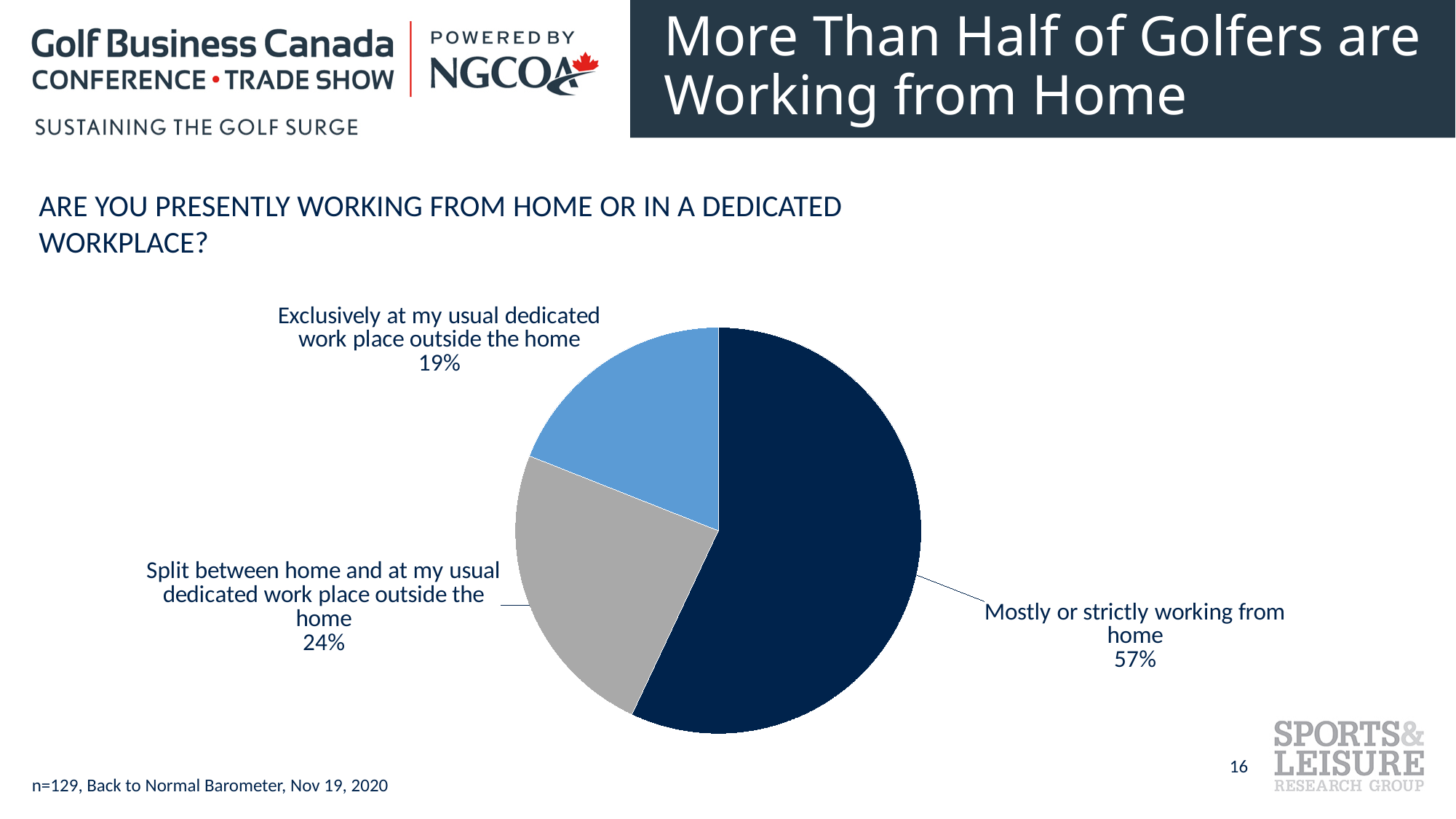
What share of golfers are mostly or strictly working from home? 57% What percentage of golfers are split between home and their usual dedicated work place outside the home? 24% What is the combined share of golfers who work at least partly outside the home (split plus exclusively at work place)? 43% Which category has the largest share of the pie? Mostly or strictly working from home Which category has the smallest share of the pie? Exclusively at my usual dedicated work place outside the home Which is larger: the share split between home and the usual work place, or the share exclusively at the usual work place? Split between home and at my usual dedicated work place outside the home What is the difference in percentage points between 'Mostly or strictly working from home' and 'Split between home and at my usual dedicated work place outside the home'? 33 percentage points How many categories does the pie chart show? 3 What survey question does the pie chart answer? Are you presently working from home or in a dedicated workplace? What is the sample size noted at the bottom of the slide? n=129 What kind of chart is shown on the slide? pie chart What percentage of golfers work exclusively at their usual dedicated work place outside the home? 19%